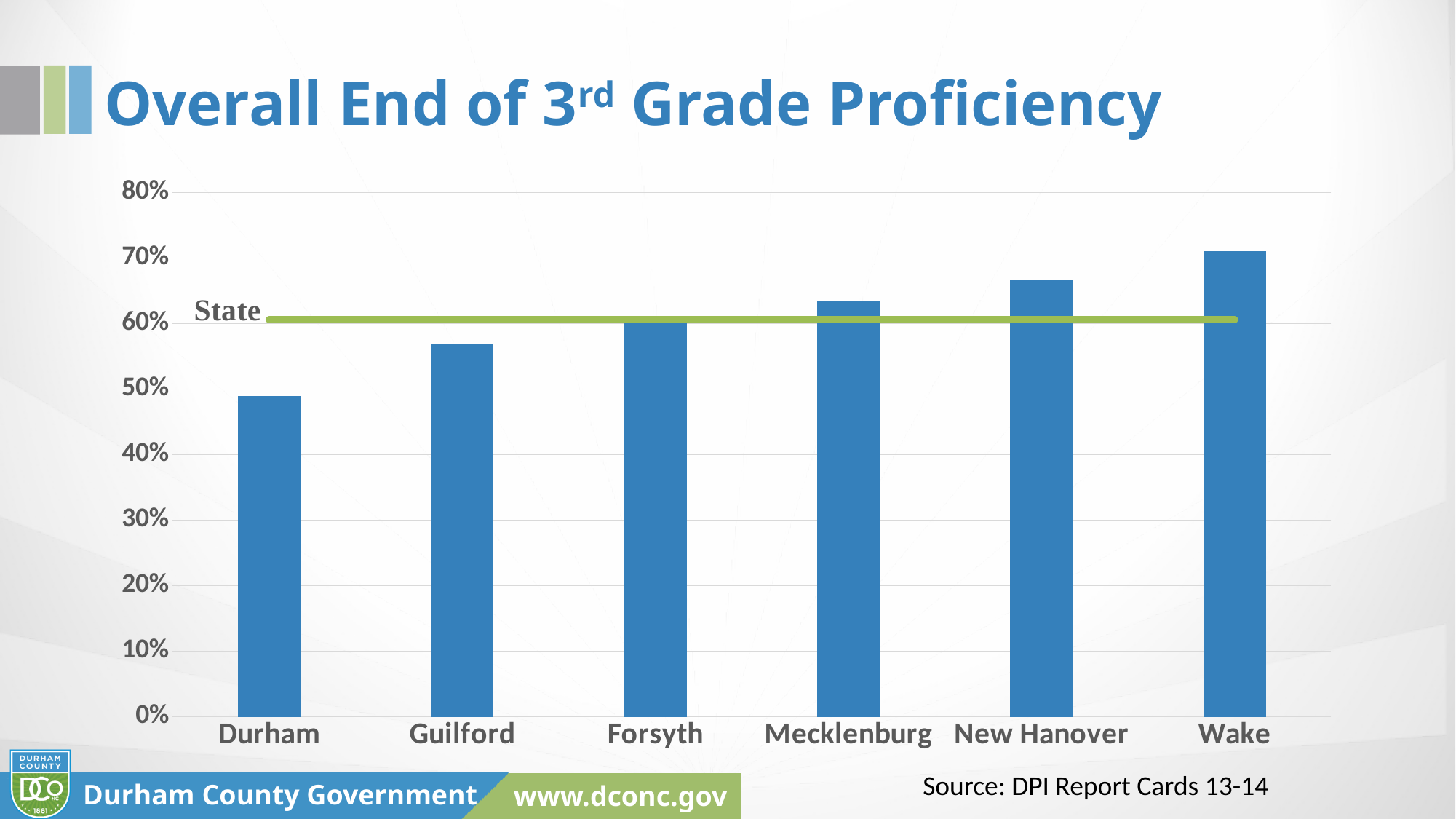
How many counties are shown on the x axis of the chart? 6 What does the green horizontal line on the chart represent? State Is the value for Guilford greater or less than 60%? less Which has a higher proficiency value, Durham or New Hanover? New Hanover Which county has the lowest end of 3rd grade proficiency? Durham Is the value for Durham greater or less than 40%? greater Is the value for Wake greater or less than 60%? greater What kind of chart is shown on the slide? bar chart Which county has the highest end of 3rd grade proficiency? Wake Which has a higher proficiency value, Guilford or Mecklenburg? Mecklenburg Do the bar values rise or fall moving from left to right across the x axis? rise